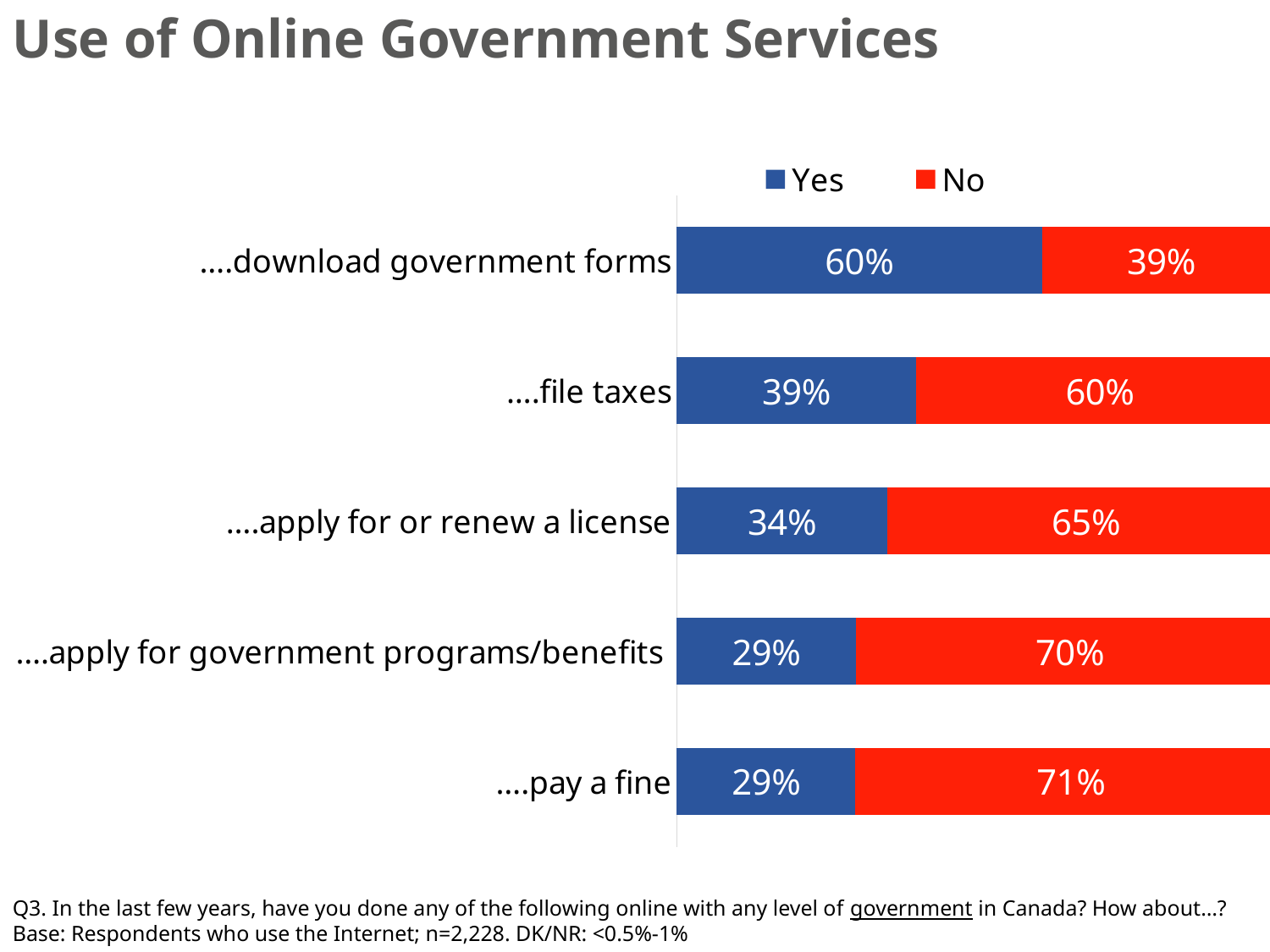
What kind of chart is shown on the slide? stacked bar chart What is the Yes value for applying for or renewing a license online? 34% Which activity has the highest No percentage? pay a fine Which activity has the highest Yes percentage? download government forms What percentage of respondents said Yes to downloading government forms online? 60% How many activities are shown in the chart? 5 How many series does the legend list? 2 Which is larger: the Yes value for filing taxes or the Yes value for applying for government programs/benefits? file taxes What is the difference between the Yes percentages for downloading government forms and filing taxes? 21% What is the No value for paying a fine online? 71% What colour represents the No responses in the chart? red What percentage of respondents said No to filing taxes online? 60%